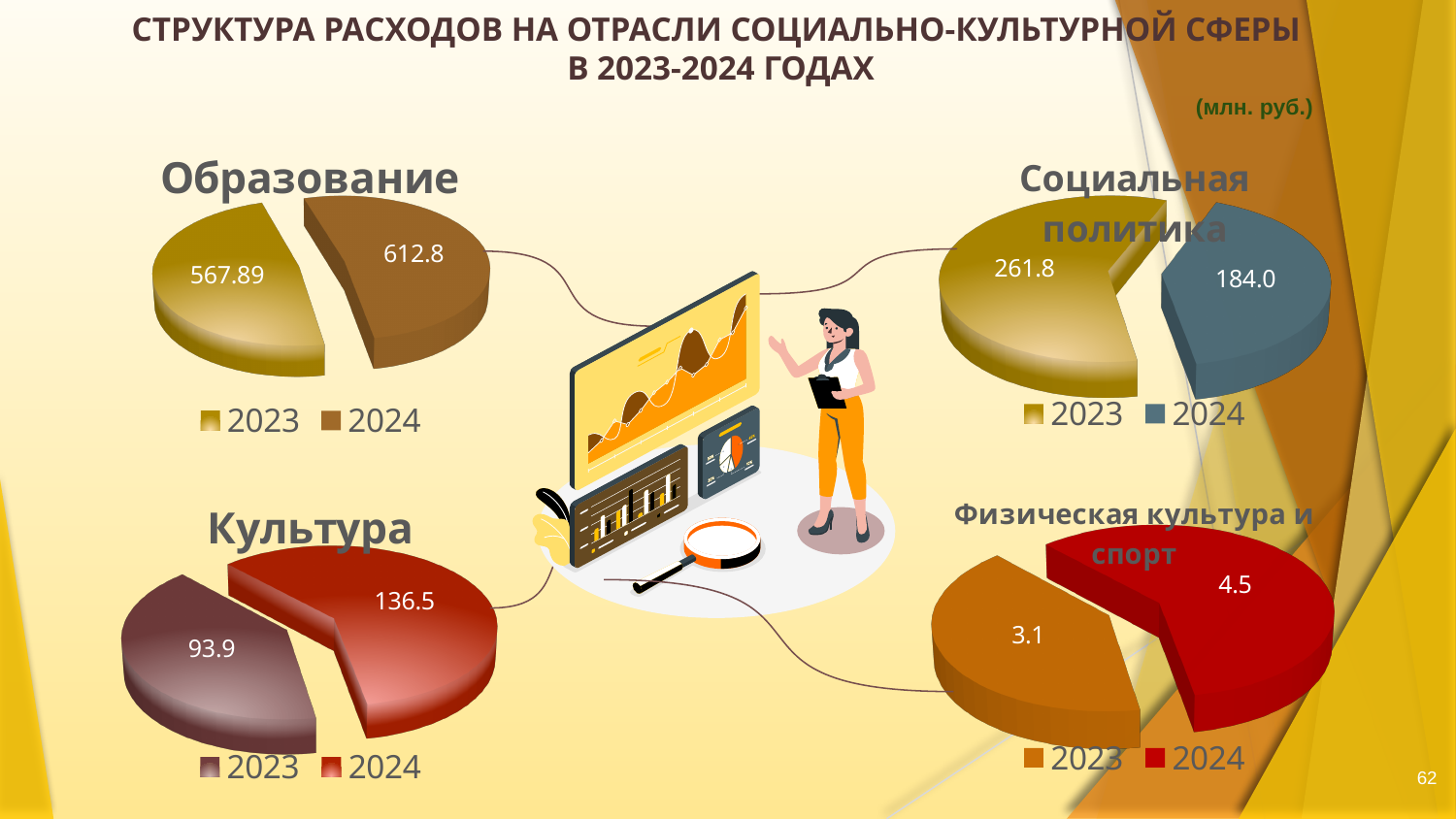
In the 'Культура' pie chart, what is the value for 2023? 93.9 In the 'Образование' pie chart, what is the value for 2024? 612.8 In the 'Физическая культура и спорт' pie chart, what is the value for 2024? 4.5 In the 'Физическая культура и спорт' pie chart, what is the difference between the 2024 and 2023 values? 1.4 In the 'Социальная политика' pie chart, which year has the larger value? 2023 In the 'Социальная политика' pie chart, what is the value for 2024? 184.0 In the 'Социальная политика' pie chart, what is the difference between the 2023 and 2024 values? 77.8 In the 'Образование' pie chart, what is the value for 2023? 567.89 In the 'Образование' pie chart, is the value for 2024 larger or smaller than the value for 2023? larger How many entries does the legend of the 'Физическая культура и спорт' chart list? 2 What type of chart is used for 'Культура'? pie chart In the 'Культура' pie chart, which year has the smaller value? 2023